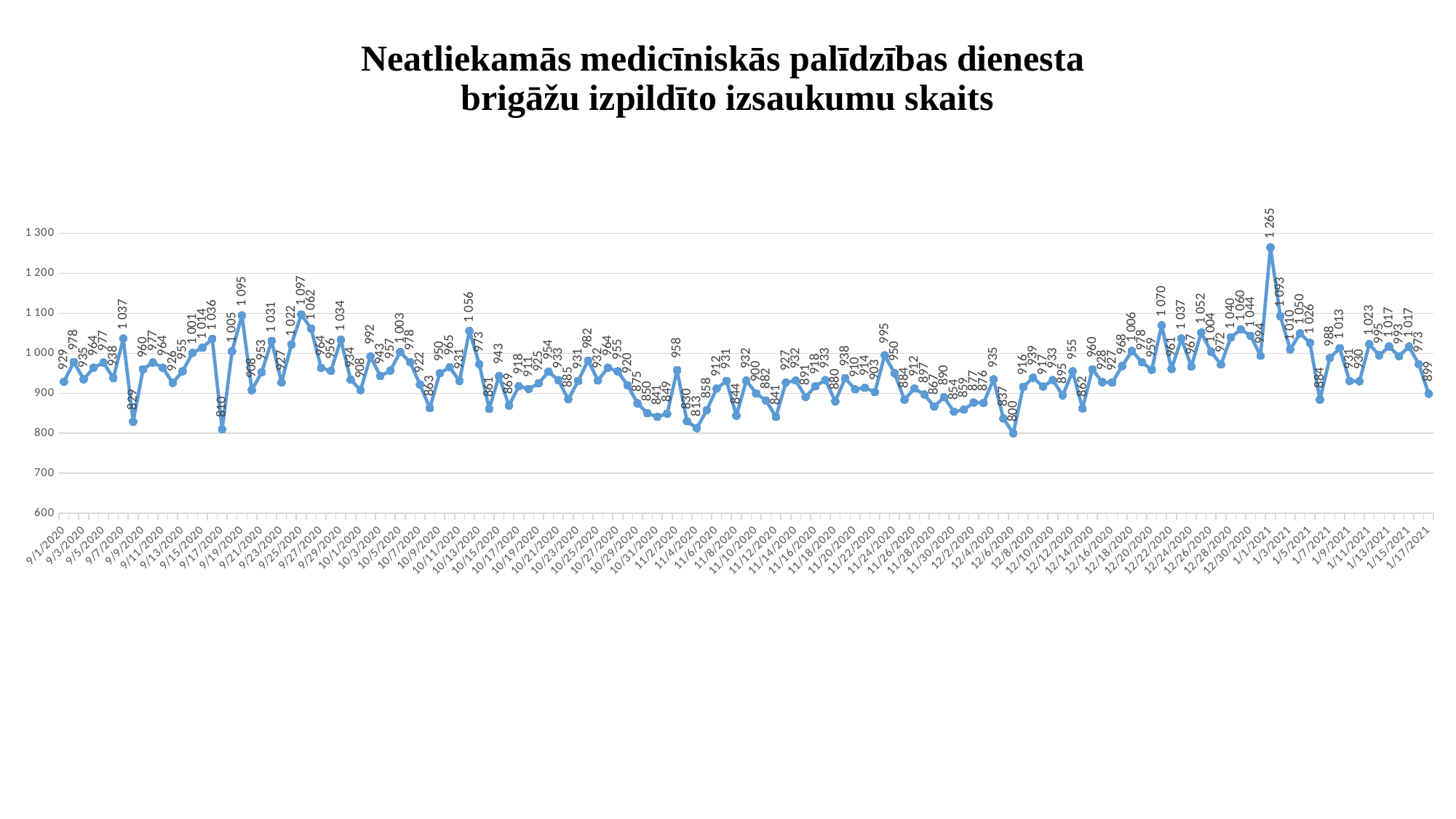
What is the difference between the highest and lowest values on the chart? 465 What is the highest value plotted on the chart? 1 265 What is the difference between the value for 9/1/2020 and the value for 1/17/2021? 30 How many points on the chart have a value above 1 200? 1 Is the value for 1/3/2021 greater or less than 1 200? less Which is larger, the value for 9/1/2020 or the value for 1/17/2021? 9/1/2020 What is the title of the chart? Neatliekamās medicīniskās palīdzības dienesta brigāžu izpildīto izsaukumu skaits What kind of chart is shown on the slide? line chart What is the lowest value plotted on the chart? 800 What is the value for 1/17/2021, the last point on the chart? 899 What is the value for 9/1/2020, the first point on the chart? 929